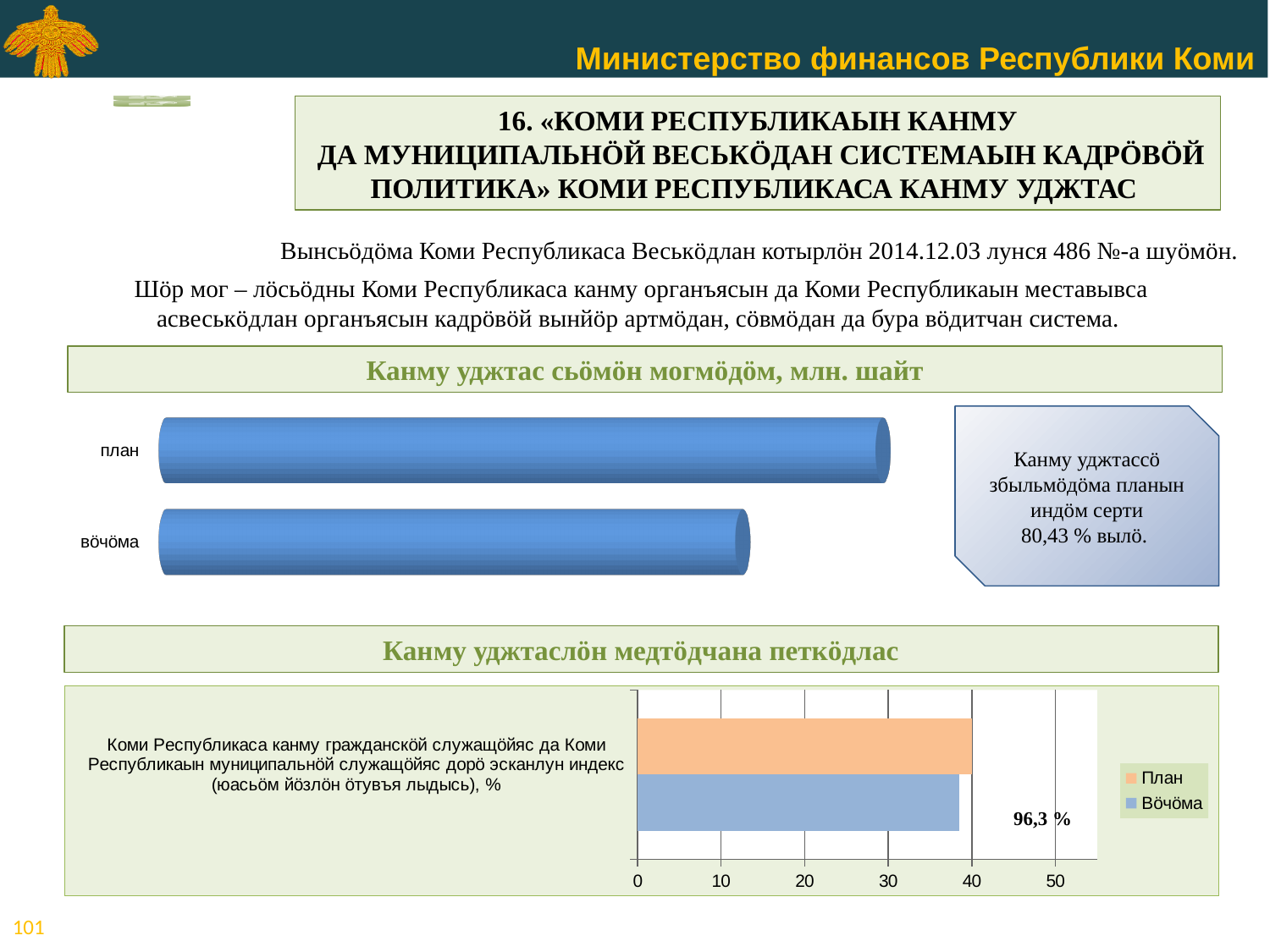
What is the title of the top chart on the slide? Канму уджтас сьӧмӧн могмӧдӧм, млн. шайт In the bottom chart titled «Канму уджтаслӧн медтӧдчана петкӧдлас», which series has the larger value, План or Вӧчӧма? План In the top chart titled «Канму уджтас сьӧмӧн могмӧдӧм, млн. шайт», which category has the longer bar, план or вӧчӧма? план In the bottom chart titled «Канму уджтаслӧн медтӧдчана петкӧдлас», is the value for Вӧчӧма greater or less than 50? less In the top chart titled «Канму уджтас сьӧмӧн могмӧдӧм, млн. шайт», which category has the lowest value? вӧчӧма In the bottom chart titled «Канму уджтаслӧн медтӧдчана петкӧдлас», is the value for План greater or less than 30? greater In the bottom chart titled «Канму уджтаслӧн медтӧдчана петкӧдлас», what kind of chart is shown? bar chart In the bottom chart titled «Канму уджтаслӧн медтӧдчана петкӧдлас», how many series does the legend list? 2 In the top chart titled «Канму уджтас сьӧмӧн могмӧдӧм, млн. шайт», how many categories are plotted? 2 In the bottom chart titled «Канму уджтаслӧн медтӧдчана петкӧдлас», what are the legend entries? План, Вӧчӧма In the top chart titled «Канму уджтас сьӧмӧн могмӧдӧм, млн. шайт», what kind of chart is shown? bar chart In the bottom chart titled «Канму уджтаслӧн медтӧдчана петкӧдлас», is the value for Вӧчӧма greater or less than 30? greater